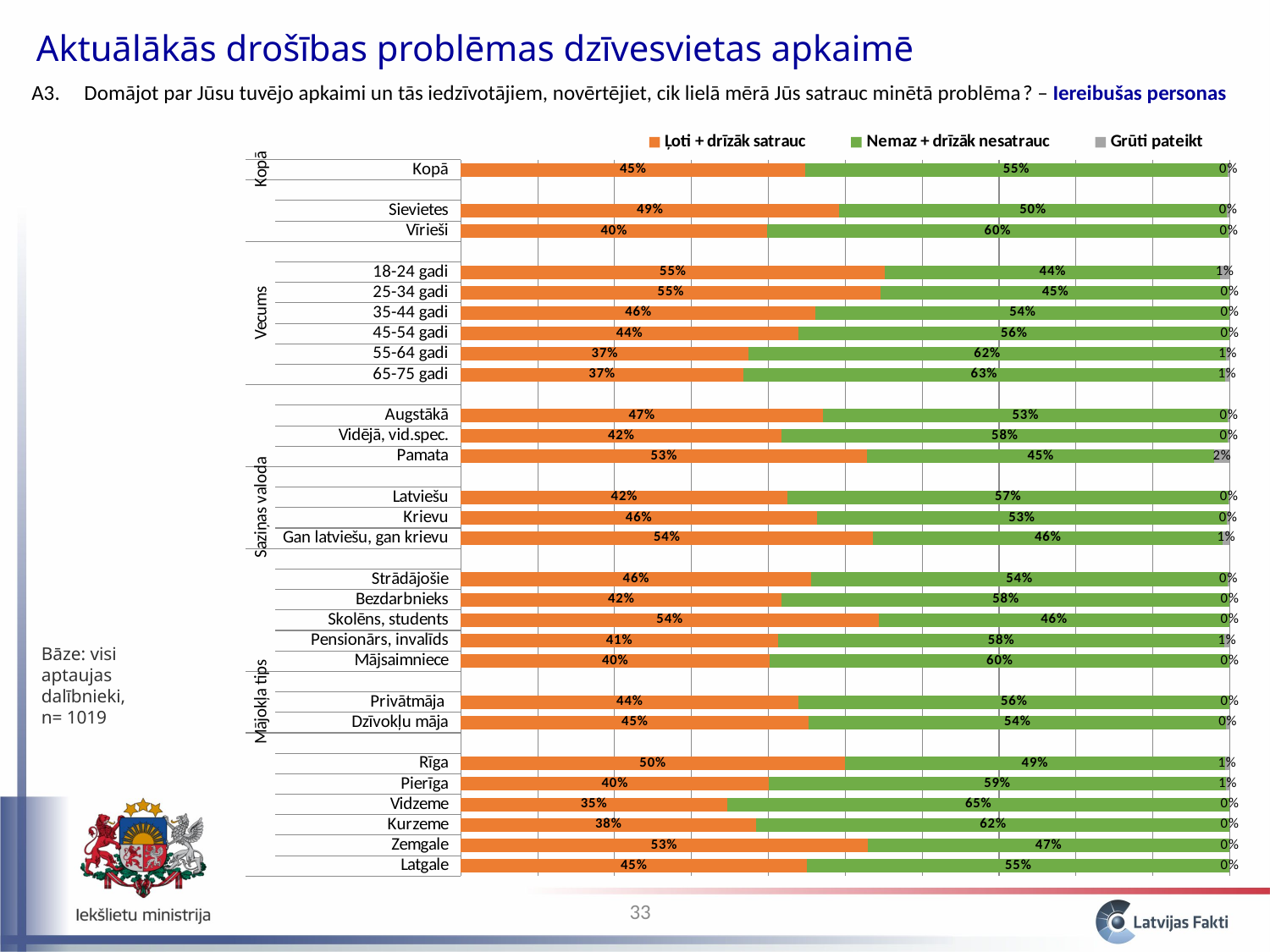
What is the "Ļoti + drīzāk satrauc" value for Kopā? 45% Which category has the highest "Nemaz + drīzāk nesatrauc" value? Vidzeme What is the difference between the "Ļoti + drīzāk satrauc" values for Sievietes and Vīrieši? 9% Which category has the lowest "Ļoti + drīzāk satrauc" value? Vidzeme Which series is shown in orange in the chart? Ļoti + drīzāk satrauc What is the "Nemaz + drīzāk nesatrauc" value for Vīrieši? 60% What is the total of the stacked bar for Zemgale? 100% What is the "Grūti pateikt" value for Pamata? 2% What is the "Ļoti + drīzāk satrauc" value for Gan latviešu, gan krievu? 54% Which has a larger "Ļoti + drīzāk satrauc" value, Rīga or Pierīga? Rīga How many series does the chart legend list? 3 What kind of chart is shown on the slide? stacked bar chart